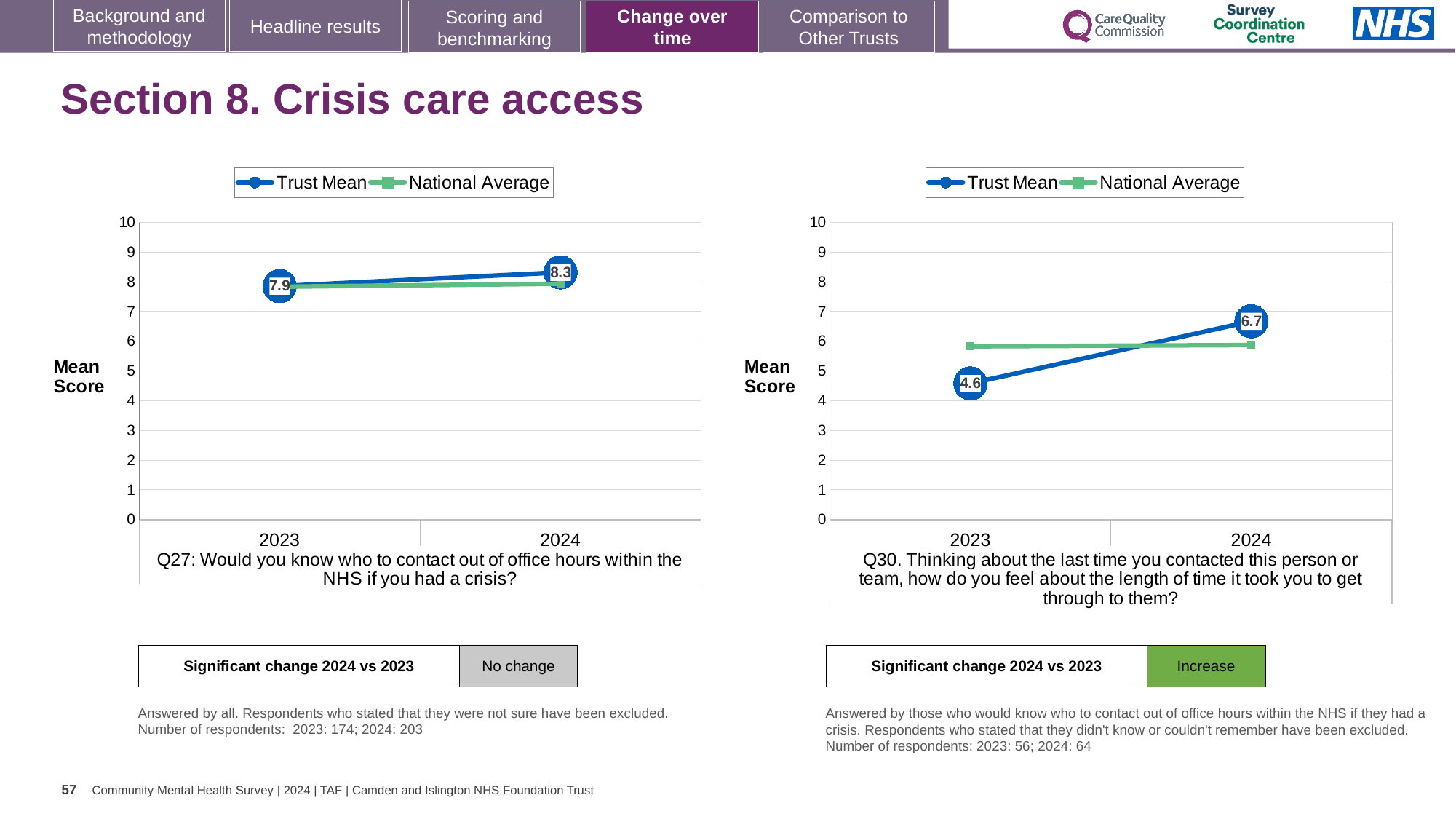
In the left chart (Q27), what is the Trust Mean for 2023? 7.9 What kind of chart is the right chart (Q30)? line chart In the left chart (Q27), what is the difference between the Trust Mean in 2024 and in 2023? 0.4 In the right chart (Q30), does the Trust Mean rise or fall from 2023 to 2024? rise In the right chart (Q30), what is the Trust Mean for 2023? 4.6 In the right chart (Q30), by how much did the Trust Mean change from 2023 to 2024? 2.1 In the right chart (Q30), is the Trust Mean for 2023 greater or less than the National Average for 2023? less In the right chart (Q30), what is the Trust Mean for 2024? 6.7 How many series does the legend of the left chart (Q27) list? 2 What does the 'Significant change 2024 vs 2023' box below the right chart (Q30) say? Increase In the left chart (Q27), what is the Trust Mean for 2024? 8.3